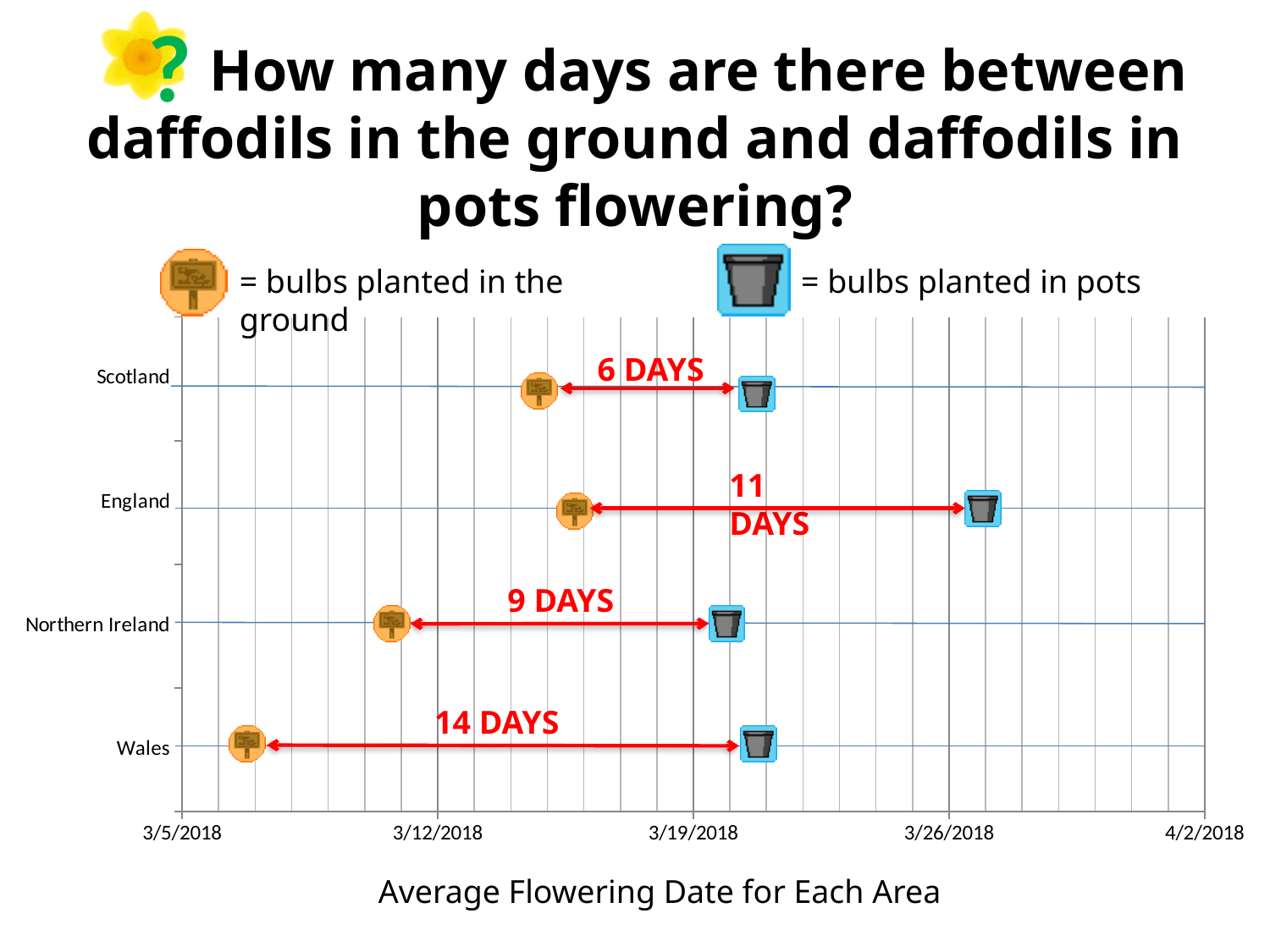
What is the title of the horizontal axis? Average Flowering Date for Each Area How many series does the legend list? 2 Which area has the smallest gap in days between ground and pot daffodils flowering? Scotland Which has a larger flowering gap in days, England or Northern Ireland? England How many days are there between ground and pot daffodils flowering in Northern Ireland? 9 days How many days are there between ground and pot daffodils flowering in England? 11 days Is the average flowering date for bulbs planted in the ground in Wales before or after 3/12/2018? before Which area has the largest gap in days between ground and pot daffodils flowering? Wales How many more days is the flowering gap in Wales than in Scotland? 8 days How many days are there between ground and pot daffodils flowering in Wales? 14 days How many areas are shown on the chart? 4 How many days are there between ground and pot daffodils flowering in Scotland? 6 days